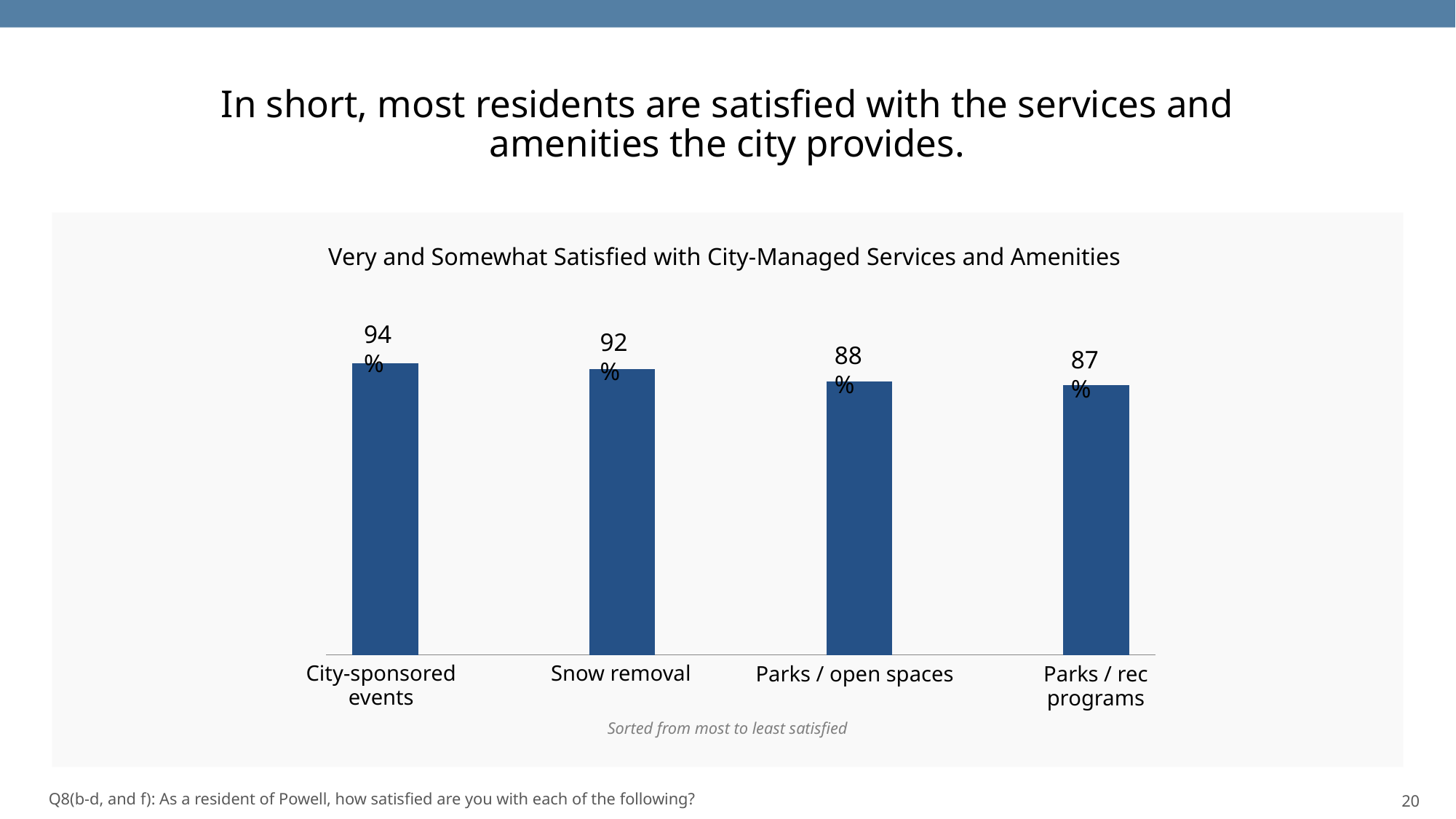
What is the title of the chart? Very and Somewhat Satisfied with City-Managed Services and Amenities What is the difference in percentage points between City-sponsored events and Parks / rec programs? 7 Which has a higher satisfaction percentage, Snow removal or Parks / open spaces? Snow removal What percentage of residents are very or somewhat satisfied with City-sponsored events? 94% How many services or amenities are shown in the chart? 4 What is the satisfaction value shown for Parks / open spaces? 88% What is the satisfaction value shown for Snow removal? 92% What is the difference in percentage points between Snow removal and Parks / open spaces? 4 What is the satisfaction value shown for Parks / rec programs? 87% Which service or amenity has the highest satisfaction percentage? City-sponsored events What type of chart is shown on the slide? Bar chart Which service or amenity has the lowest satisfaction percentage? Parks / rec programs